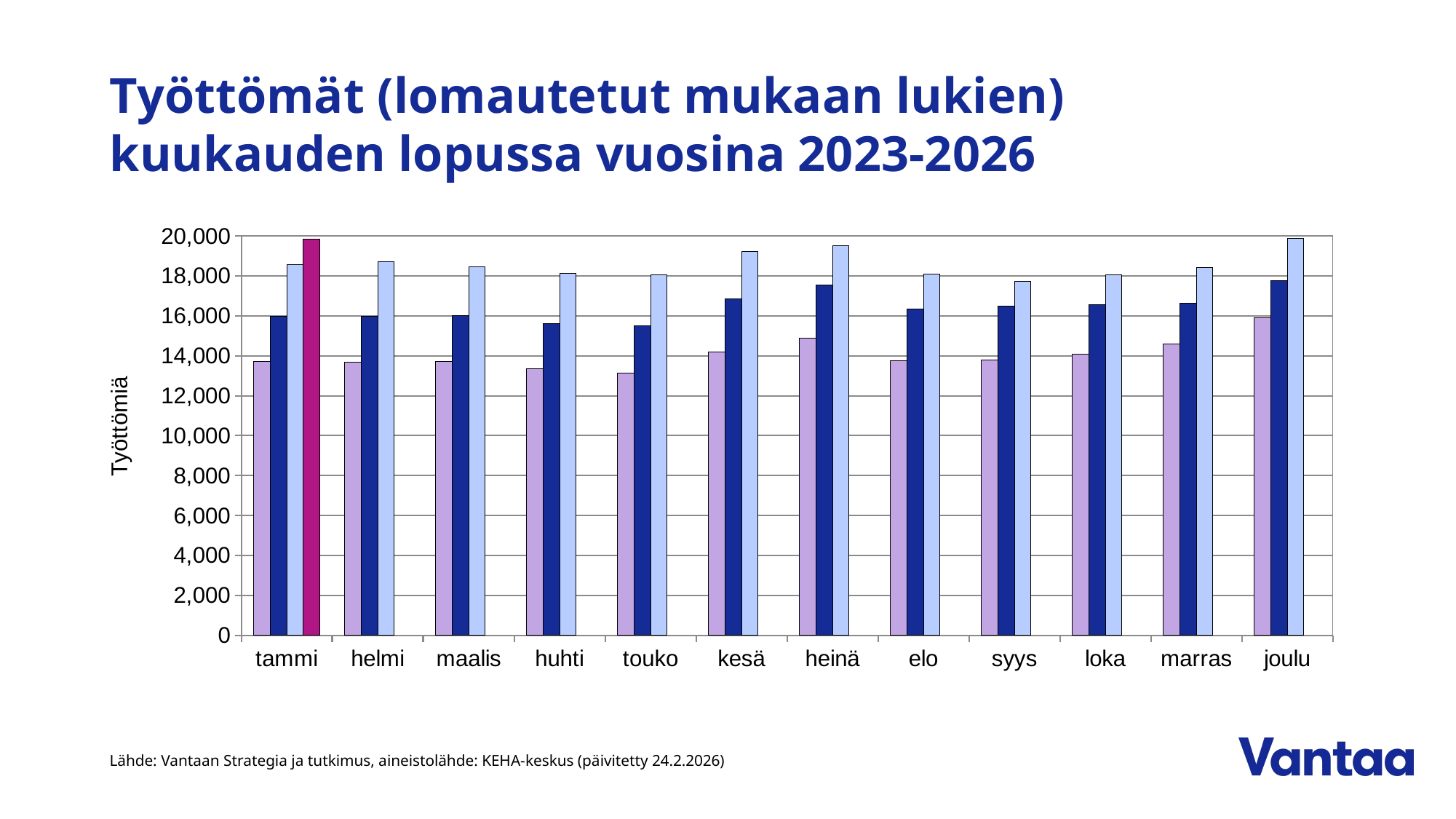
What is the title of the chart on the slide? Työttömät (lomautetut mukaan lukien) kuukauden lopussa vuosina 2023-2026 Is the value of the magenta bar for tammi greater or less than 18,000? greater Is the value of the light blue bar for joulu greater or less than 18,000? greater Is the value of the dark blue bar for kesä greater or less than 16,000? greater For joulu, which is larger: the light blue bar or the light purple bar? the light blue bar What kind of chart is shown on the slide? bar chart For tammi, which is larger: the magenta bar or the light purple bar? the magenta bar Do the dark blue bars rise or fall from touko to heinä? rise What is the label of the vertical axis? Työttömiä How many month categories are shown on the x axis? 12